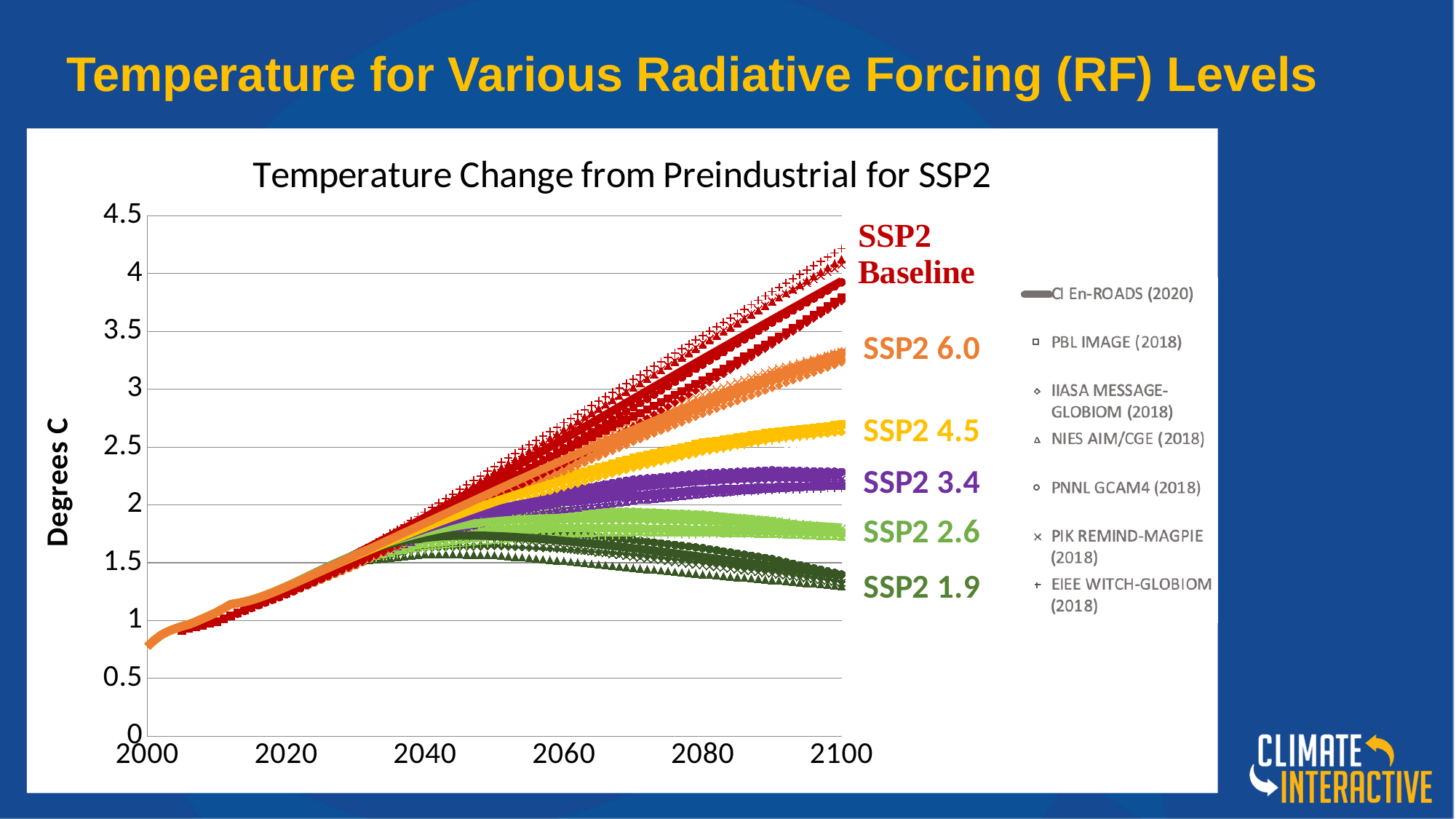
Is the temperature change for SSP2 6.0 in 2100 greater or less than 3 degrees C? greater How many SSP2 scenario groups are labelled on the chart? 6 What kind of chart is shown on the slide? line chart Is the temperature change for SSP2 1.9 in 2100 greater or less than 1.5 degrees C? less How many model entries does the chart's legend list? 7 Which SSP2 scenario has the highest temperature change in 2100? SSP2 Baseline What is the label on the vertical axis of the chart? Degrees C What is the title of the chart? Temperature Change from Preindustrial for SSP2 Is the temperature change for SSP2 Baseline in 2100 greater or less than 3.5 degrees C? greater Does the temperature change for SSP2 Baseline rise or fall from 2000 to 2100? rise Which SSP2 scenario has the lowest temperature change in 2100? SSP2 1.9